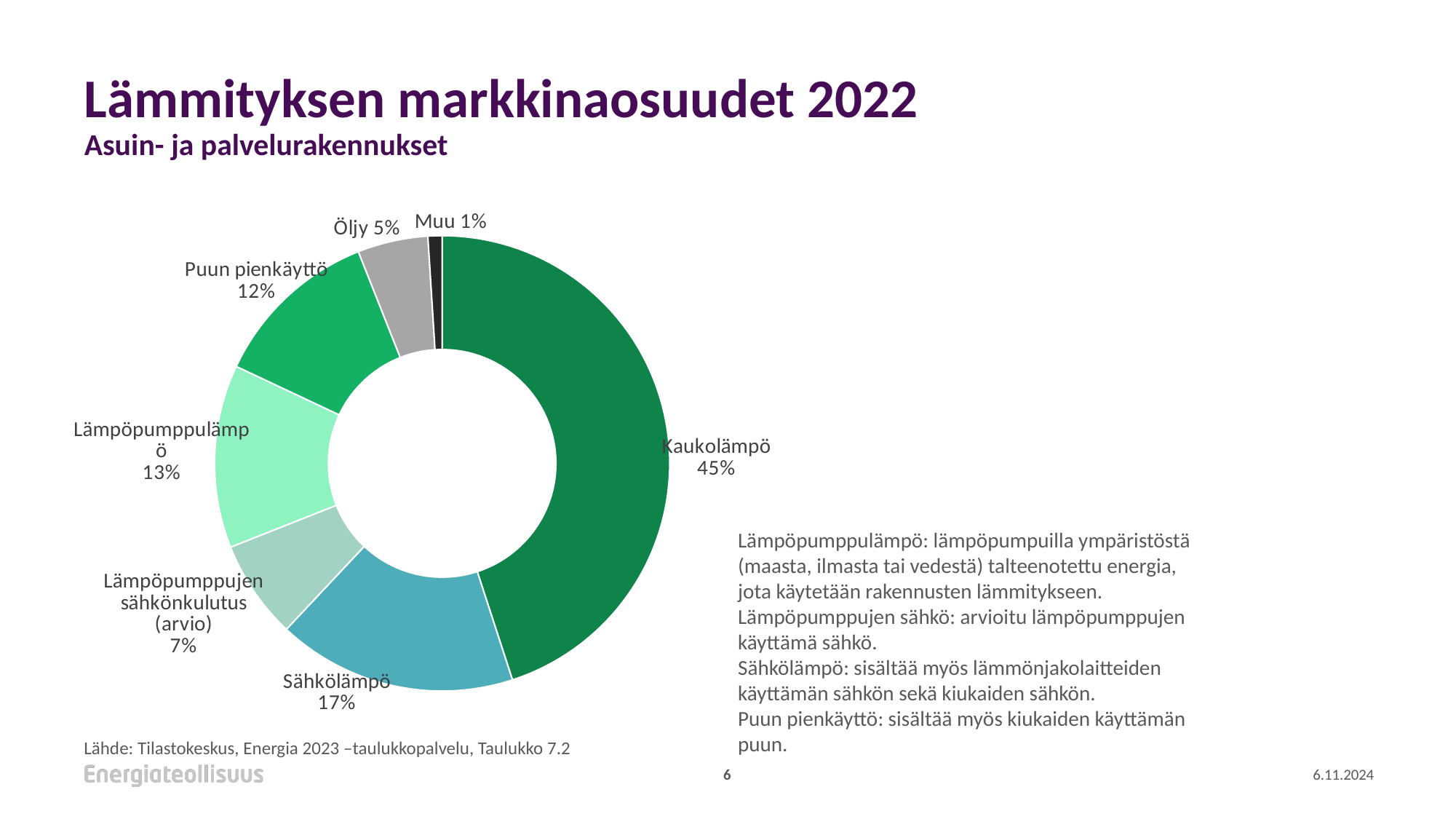
What is the title of the chart on the slide? Lämmityksen markkinaosuudet 2022 What kind of chart is shown on the slide? Doughnut (pie) chart What share does Puun pienkäyttö have in the chart? 12% Which category has the largest share in the chart? Kaukolämpö What is the difference in percentage points between Kaukolämpö and Sähkölämpö? 28 What share does Lämpöpumppulämpö have in the chart? 13% Which category has the smallest share in the chart? Muu What share does Öljy have in the chart? 5% What share does Sähkölämpö have in the chart? 17% Which has a larger share, Lämpöpumppulämpö or Puun pienkäyttö? Lämpöpumppulämpö How many categories are shown in the chart? 7 What share does Kaukolämpö have in the chart? 45%